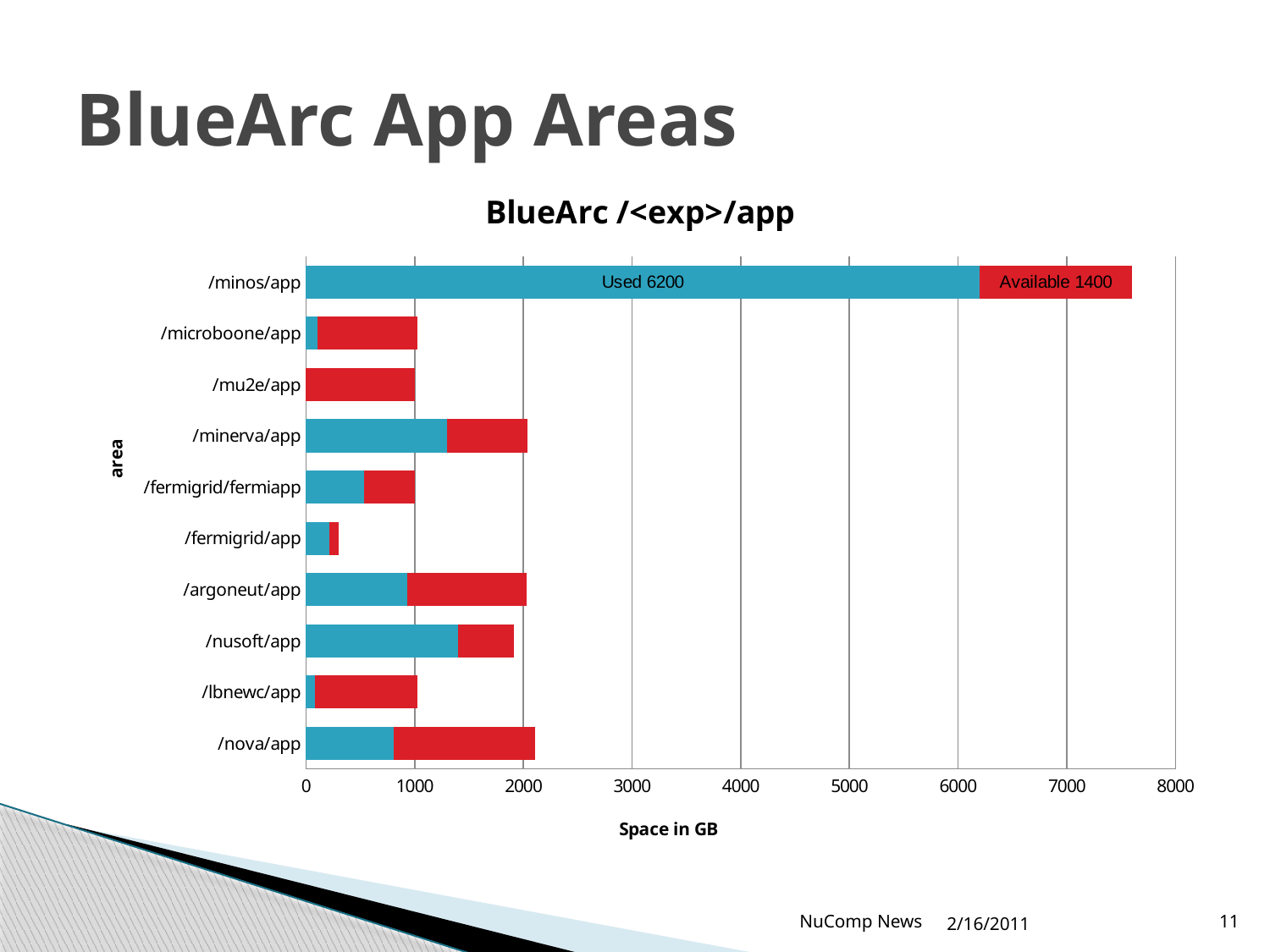
How many areas (categories) are plotted on the y axis? 10 Is the total bar for /minos/app greater or less than 7000? greater What is the total (Used plus Available) of the /minos/app bar? 7600 What is the title of the x axis? Space in GB Which area has the longest total bar? /minos/app Which has the larger total bar, /minos/app or /nova/app? /minos/app What kind of chart is shown on the slide? bar chart What is the Used value for /minos/app? 6200 Which area has the shortest total bar? /fermigrid/app Is the total bar for /fermigrid/app greater or less than 1000? less What is the Available value for /minos/app? 1400 Is the Used (blue) portion for /minerva/app greater or less than 1000? greater